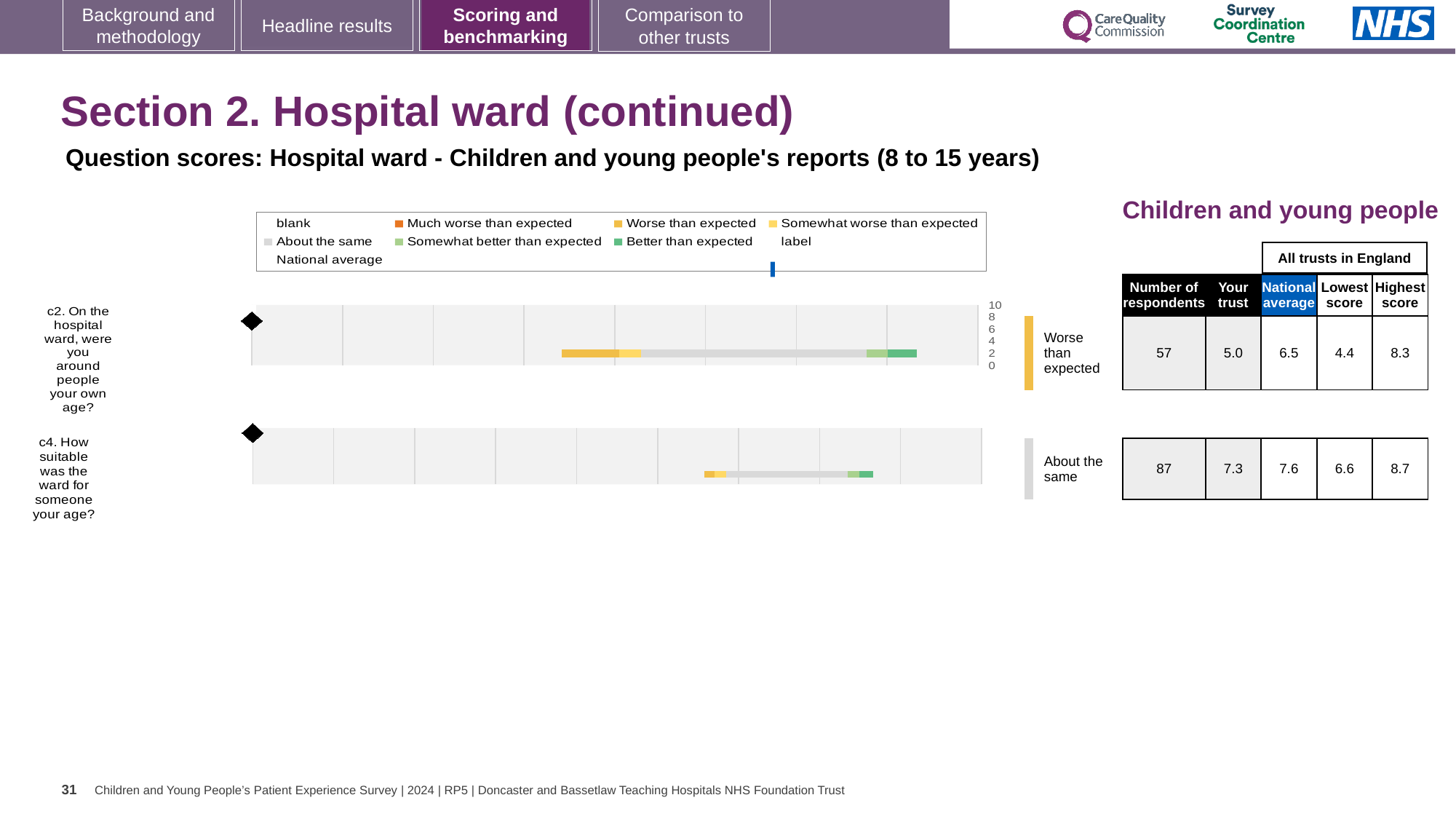
What benchmark category is shown for question c2? Worse than expected What is the difference between the national average and the trust's score for question c2? 1.5 What is the lowest score among all trusts in England for question c4? 6.6 How many questions are plotted on this slide? 2 What is the national average score for question c4? 7.6 What is the highest score among all trusts in England for question c2? 8.3 What is the 'Your trust' score for question c4 (How suitable was the ward for someone your age?)? 7.3 What is the 'Your trust' score for question c2 (On the hospital ward, were you around people your own age?)? 5.0 What is the national average score for question c2? 6.5 What benchmark category is shown for question c4? About the same Which question has the higher 'Your trust' score, c2 or c4? c4 How many respondents answered question c4? 87